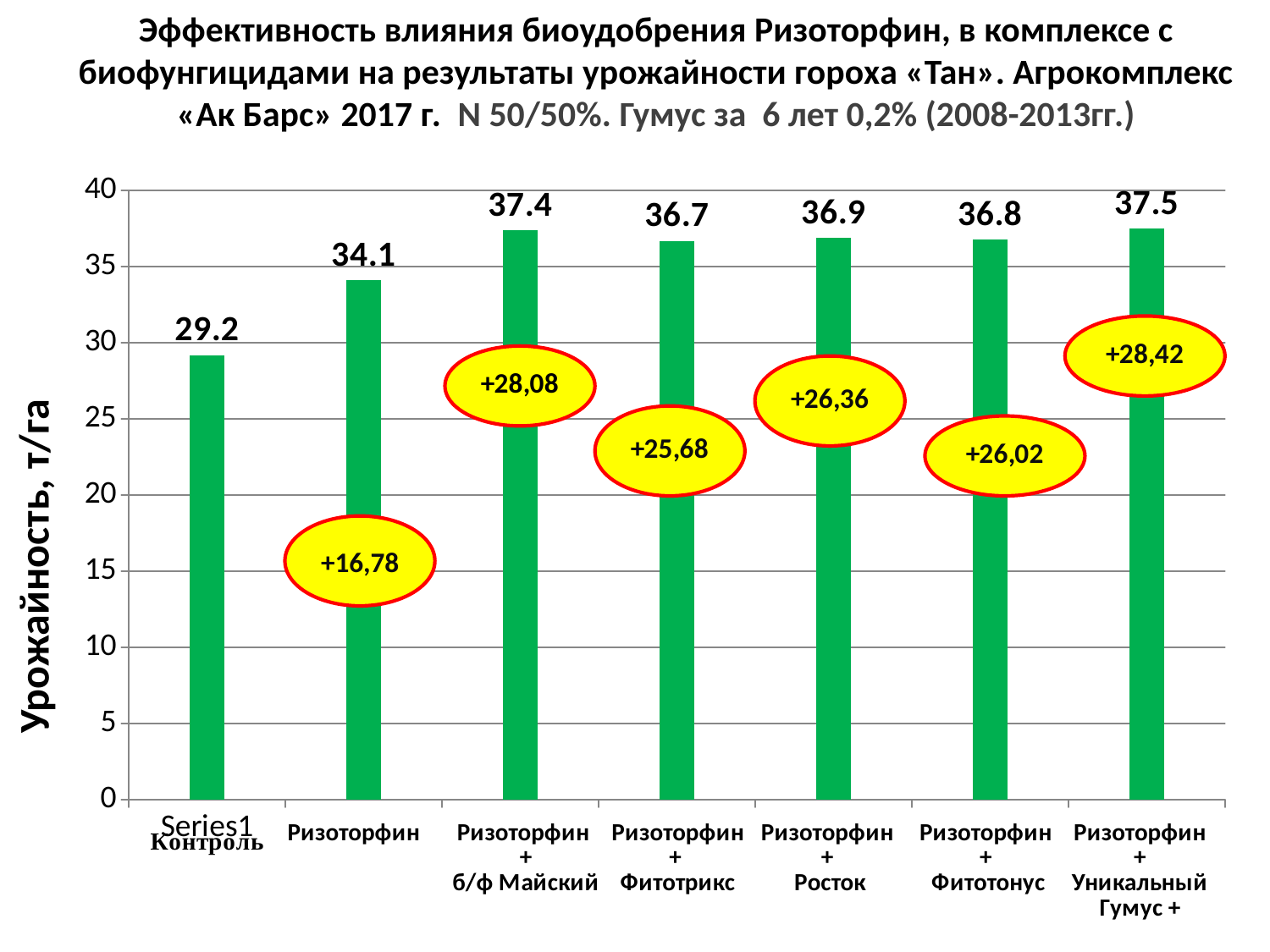
What is the difference between the yield for Ризоторфин + б/ф Майский and the yield for Контроль? 8.2 How many categories are shown on the x axis? 7 What is the yield value for Ризоторфин + Росток? 36.9 What type of chart is shown on the slide? bar chart What is the yield value for Ризоторфин? 34.1 What is the yield value for Ризоторфин + Фитотрикс? 36.7 What is the yield value for Контроль? 29.2 What percentage increase is shown in the yellow oval for Ризоторфин + Уникальный Гумус +? +28,42 Which category has the highest yield? Ризоторфин + Уникальный Гумус + What is the label of the y axis? Урожайность, т/га Which is larger, the yield for Ризоторфин or the yield for Ризоторфин + Фитотонус? Ризоторфин + Фитотонус Which category has the lowest yield? Контроль